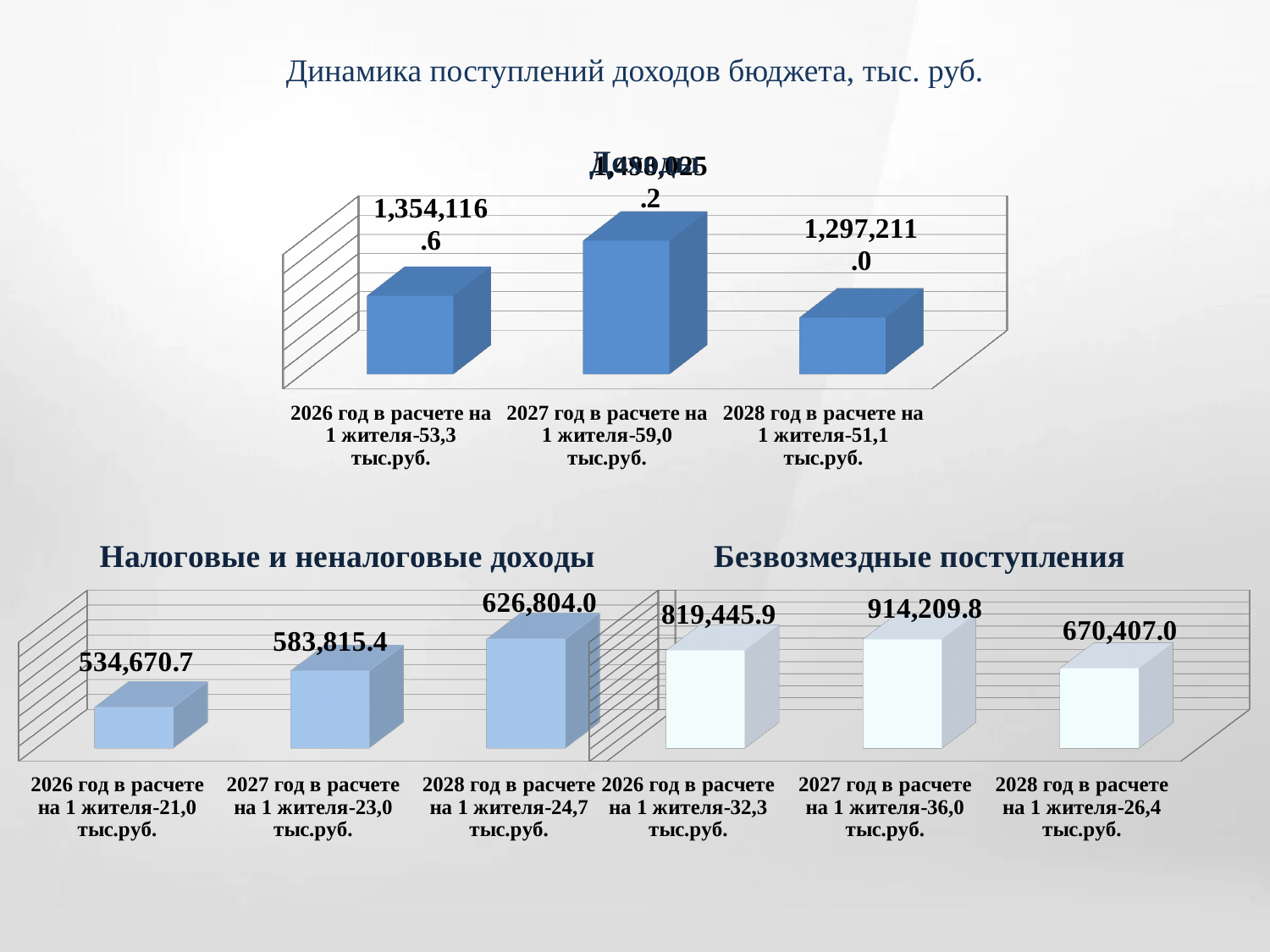
How many bars does the bottom-right chart 'Безвозмездные поступления' have? 3 In the top chart 'Доходы', which year has the lowest value? 2028 In the bottom-right chart 'Безвозмездные поступления', what is the difference between the 2027 and 2028 values? 243,802.8 In the bottom-left chart 'Налоговые и неналоговые доходы', what is the value for 2028? 626,804.0 What type of chart is the top chart 'Доходы'? bar chart In the bottom-left chart 'Налоговые и неналоговые доходы', what is the difference between the 2028 and 2026 values? 92,133.3 In the bottom-right chart 'Безвозмездные поступления', what is the value for 2028? 670,407.0 In the top chart 'Доходы', what is the value for 2026? 1,354,116.6 In the bottom-right chart 'Безвозмездные поступления', which year has the highest value? 2027 In the bottom-left chart 'Налоговые и неналоговые доходы', what is the value for 2026? 534,670.7 In the bottom-right chart 'Безвозмездные поступления', what is the value for 2027? 914,209.8 In the bottom-left chart 'Налоговые и неналоговые доходы', do the values rise or fall from 2026 to 2028? rise